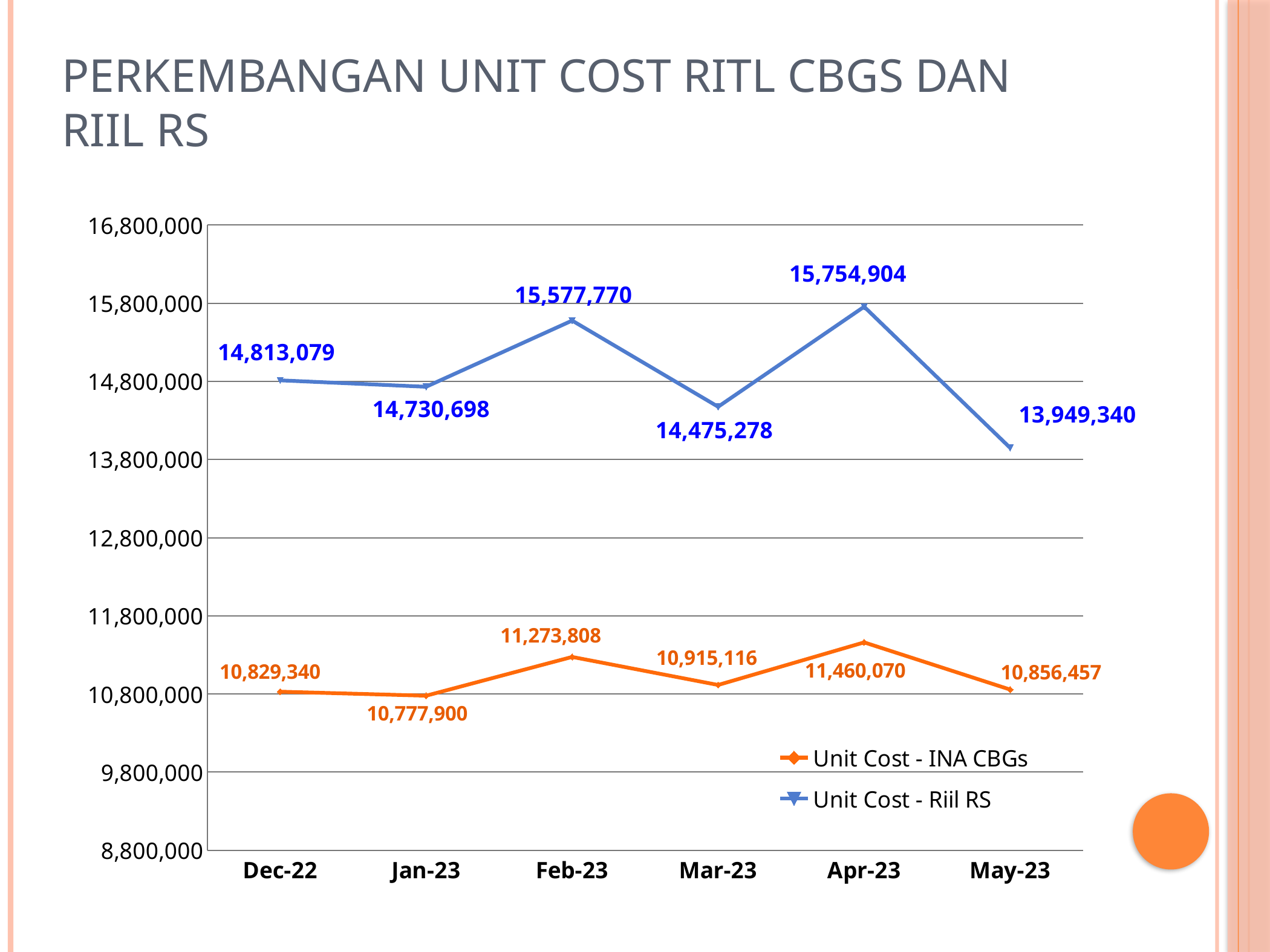
What is the value of Unit Cost - INA CBGs for Jan-23? 10,777,900 What is the value of Unit Cost - Riil RS for Apr-23? 15,754,904 In which month is Unit Cost - Riil RS highest? Apr-23 How much did Unit Cost - Riil RS fall from Apr-23 to May-23? 1,805,564 How many months are plotted on the x axis? 6 Which is larger, Unit Cost - INA CBGs in Feb-23 or in Mar-23? Feb-23 What kind of chart is shown on the slide? line chart How many series does the legend list? 2 What is the difference between Unit Cost - Riil RS and Unit Cost - INA CBGs in Apr-23? 4,294,834 Is the value of Unit Cost - Riil RS for Mar-23 greater or less than 14,800,000? less What is the value of Unit Cost - Riil RS for May-23? 13,949,340 In which month is Unit Cost - INA CBGs lowest? Jan-23